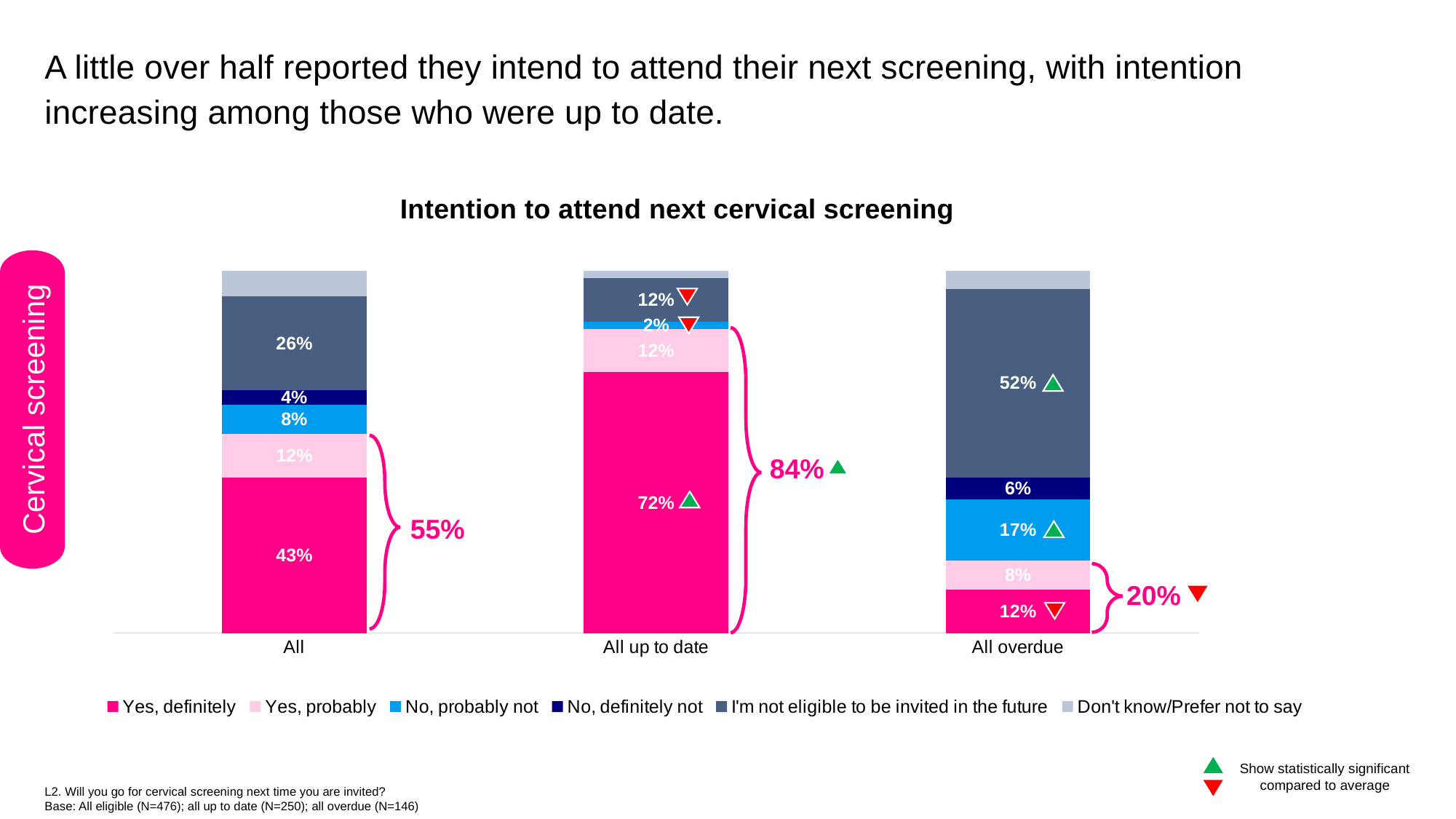
What percentage of the 'All overdue' group said 'I'm not eligible to be invited in the future'? 52% What is the difference between the 'Yes, definitely' percentages for 'All up to date' and 'All overdue'? 60% Which is larger: the 'No, definitely not' percentage for 'All' or for 'All overdue'? All overdue What percentage of the 'All up to date' group answered 'Yes, definitely'? 72% Which group has the highest 'Yes, definitely' percentage? All up to date What is the combined 'Yes' share shown by the bracket for the 'All up to date' group? 84% What percentage of the 'All overdue' group answered 'No, probably not'? 17% What percentage of the 'All' group answered 'Yes, definitely'? 43% How many groups are shown on the x axis? 3 How many series does the legend list? 6 Which group has the lowest combined 'Yes' share shown by the brackets? All overdue What kind of chart is shown? Stacked bar chart